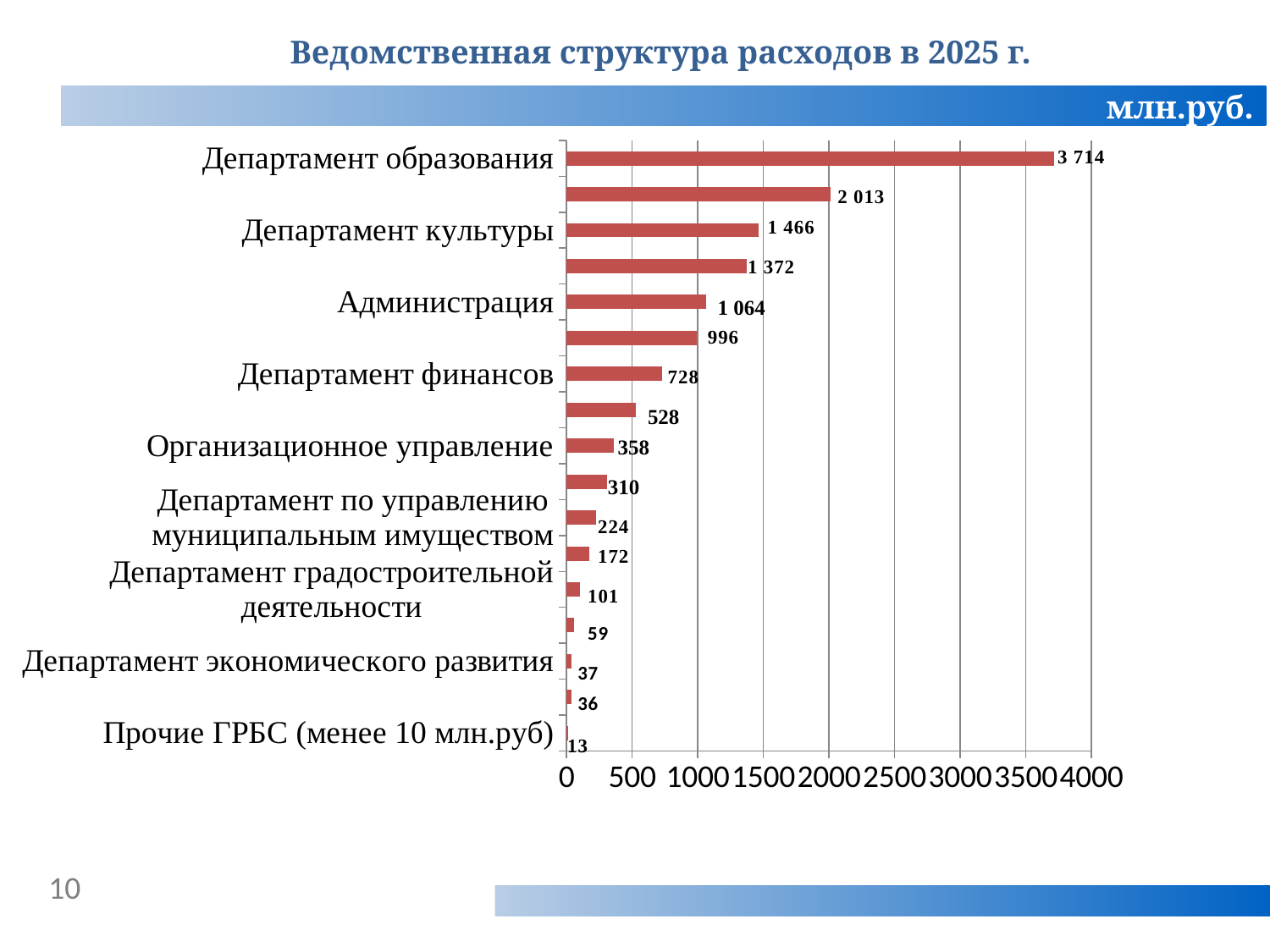
What is the value for Департамент финансов? 728 Which category has the lowest value? Прочие ГРБС (менее 10 млн.руб) What kind of chart is shown on the slide? Bar chart What is the value for Департамент культуры? 1 466 What is the value for Администрация? 1 064 What is the value for Департамент образования? 3 714 Which is larger, the value for Администрация or the value for Департамент финансов? Администрация What is the value for Организационное управление? 358 Which category has the highest value? Департамент образования What is the value for Прочие ГРБС (менее 10 млн.руб)? 13 What is the difference between the values for Департамент образования and Департамент культуры? 2 248 How many bars are plotted in the chart? 17